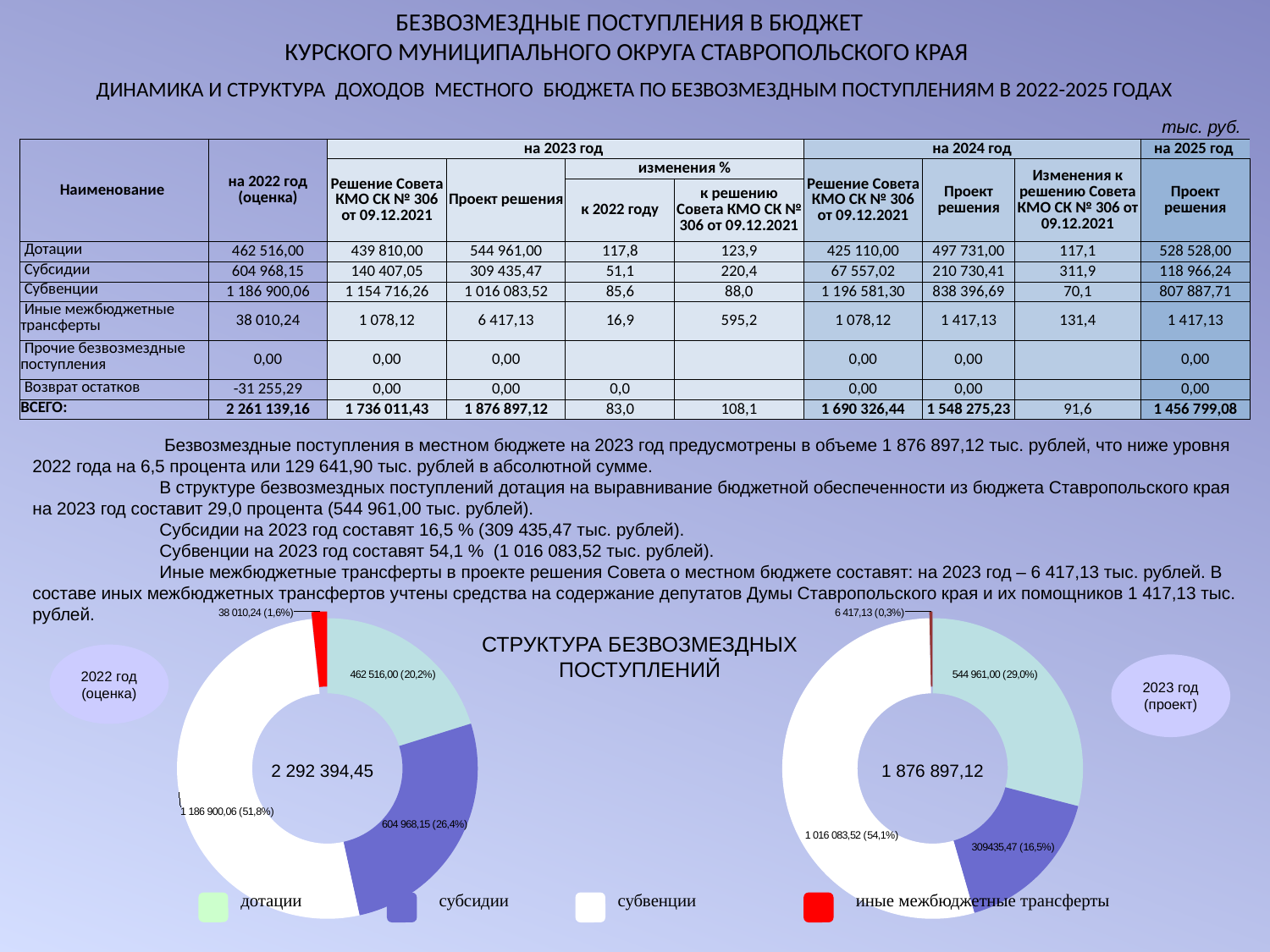
In the 2023 год (проект) donut chart, which is larger: дотации or субсидии? дотации What is the total value shown in the centre of the 2023 год (проект) donut chart? 1 876 897,12 In the 2022 год (оценка) donut chart, which category has the largest slice? субвенции In the 2022 год (оценка) donut chart, what value is shown for субвенции? 1 186 900,06 In the 2022 год (оценка) donut chart, what share of the total do субсидии make up? 26,4% In the 2023 год (проект) donut chart, what value is shown for дотации? 544 961,00 What is the total value shown in the centre of the 2022 год (оценка) donut chart? 2 292 394,45 In the legend below the donut charts, which category is shown in red? иные межбюджетные трансферты In the 2023 год (проект) donut chart, which category has the smallest slice? иные межбюджетные трансферты In the 2023 год (проект) donut chart, what share of the total do субвенции make up? 54,1% How many categories does the legend below the donut charts list? 4 What type of chart is used to show the структура безвозмездных поступлений for 2022 and 2023? pie (donut) chart